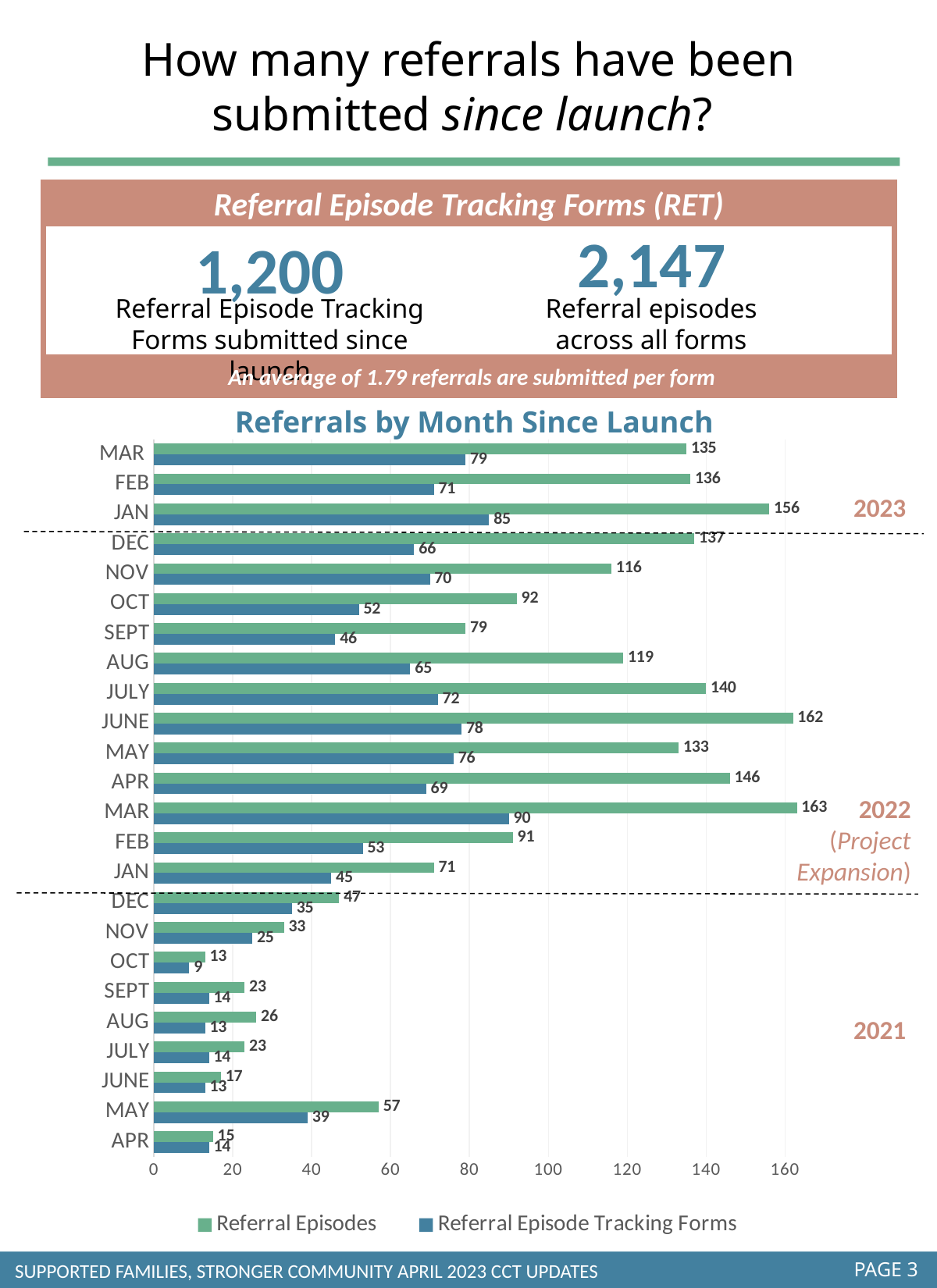
In the 'Referrals by Month Since Launch' chart, how many Referral Episode Tracking Forms were recorded in SEPT 2022? 46 In the 'Referrals by Month Since Launch' chart, which is larger: Referral Episodes in DEC 2022 or Referral Episodes in NOV 2022? DEC 2022 How many series does the legend of the 'Referrals by Month Since Launch' chart list? 2 In the 'Referrals by Month Since Launch' chart, which month has the highest number of Referral Episodes? MAR 2022 In the 'Referrals by Month Since Launch' chart, how many months are shown? 24 In the 'Referrals by Month Since Launch' chart, which colour represents Referral Episodes? green In the 'Referrals by Month Since Launch' chart, what is the difference in Referral Episodes between MAR 2022 and FEB 2022? 72 In the 'Referrals by Month Since Launch' chart, how many Referral Episodes were recorded in JAN 2023? 156 In the 'Referrals by Month Since Launch' chart, which month has the lowest number of Referral Episode Tracking Forms? OCT 2021 In the 'Referrals by Month Since Launch' chart, how many Referral Episode Tracking Forms were recorded in MAY 2021? 39 What type of chart is 'Referrals by Month Since Launch'? bar chart In the 'Referrals by Month Since Launch' chart, what is the difference between Referral Episodes and Referral Episode Tracking Forms in JUNE 2022? 84